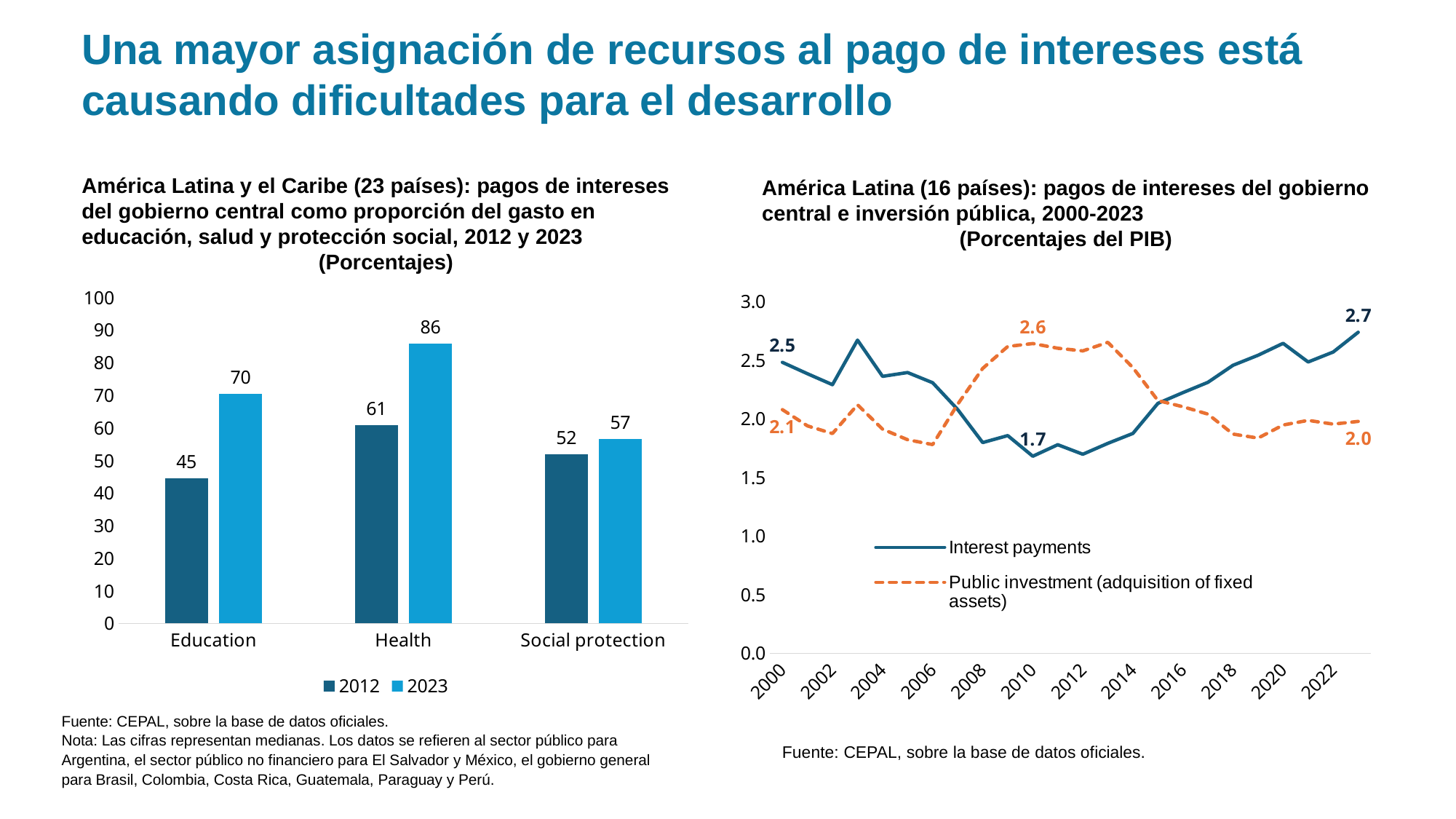
In the left bar chart, how many series does the legend list? 2 In the left bar chart, what is the value for Health in 2023? 86 What kind of chart is the chart on the right of the slide? Line chart In the right line chart, is the value for Interest payments in 2012 greater or less than 2.0? less In the right line chart, what is the labelled value of Interest payments in 2023? 2.7 In the left bar chart, how many categories are shown on the x axis? 3 In the left bar chart, what is the value for Education in 2012? 45 In the right line chart, what is the labelled value of Public investment in 2000? 2.1 In the left bar chart, which category has the lowest value in 2012? Education In the left bar chart, which is larger: Social protection in 2023 or Health in 2012? Health in 2012 In the left bar chart, what is the difference between the 2023 and 2012 values for Education? 25 In the left bar chart, which category has the highest value in 2023? Health